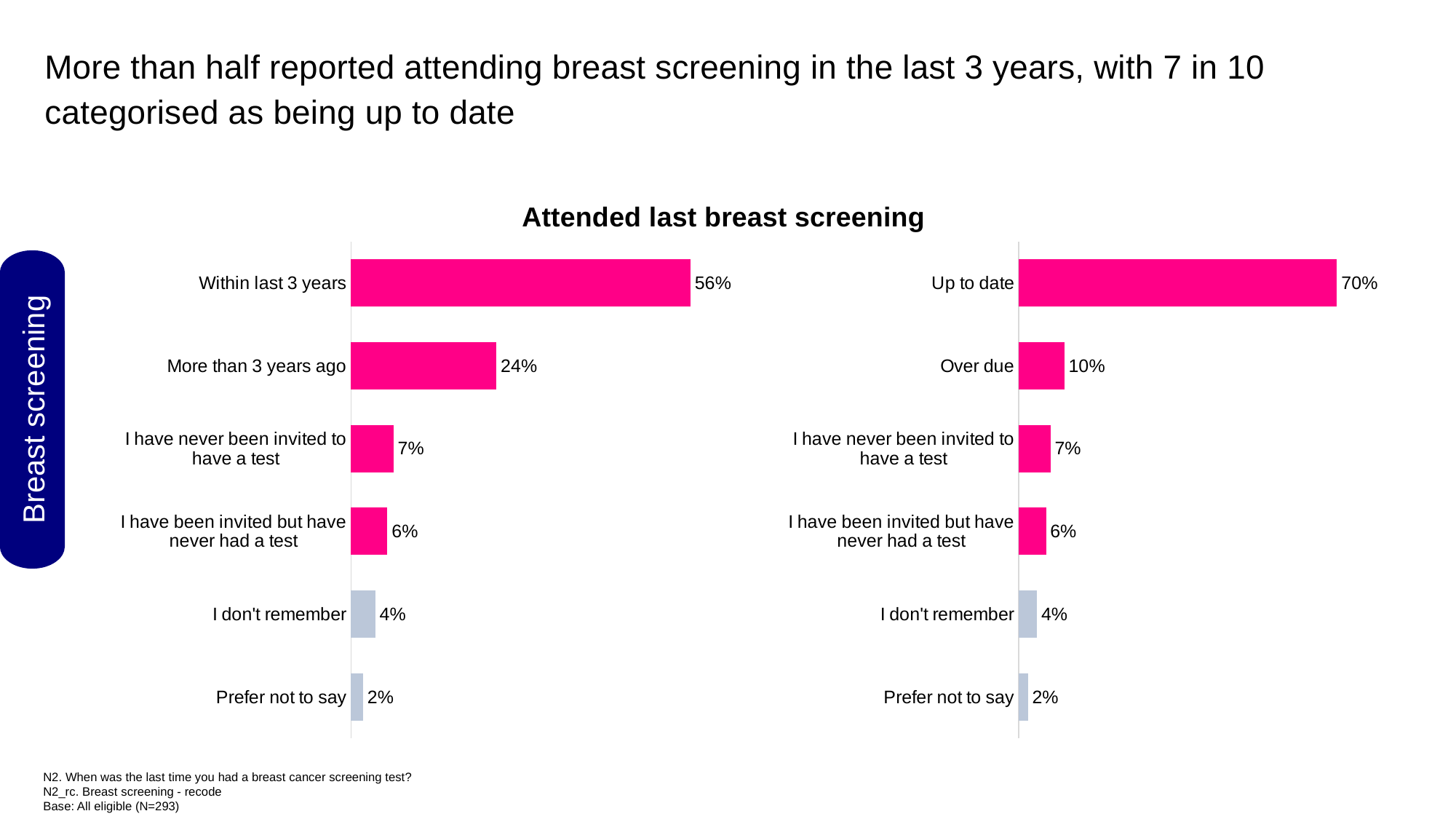
What is the title shown above the charts? Attended last breast screening What type of chart is used on this slide? Bar chart In the right chart, what percentage are categorised as over due? 10% How many categories are shown in the left chart? 6 In the left chart, what is the difference between 'Within last 3 years' and 'More than 3 years ago'? 32 percentage points In the left chart, what percentage said 'More than 3 years ago'? 24% In the left chart, which is larger: 'I have never been invited to have a test' or 'I have been invited but have never had a test'? I have never been invited to have a test In the right chart, which category has the lowest value? Prefer not to say In the right chart, what is the difference between 'Up to date' and 'Over due'? 60 percentage points In the right chart, what percentage are categorised as up to date? 70% In the left chart, what percentage reported attending breast screening within the last 3 years? 56% In the left chart, which category has the highest value? Within last 3 years